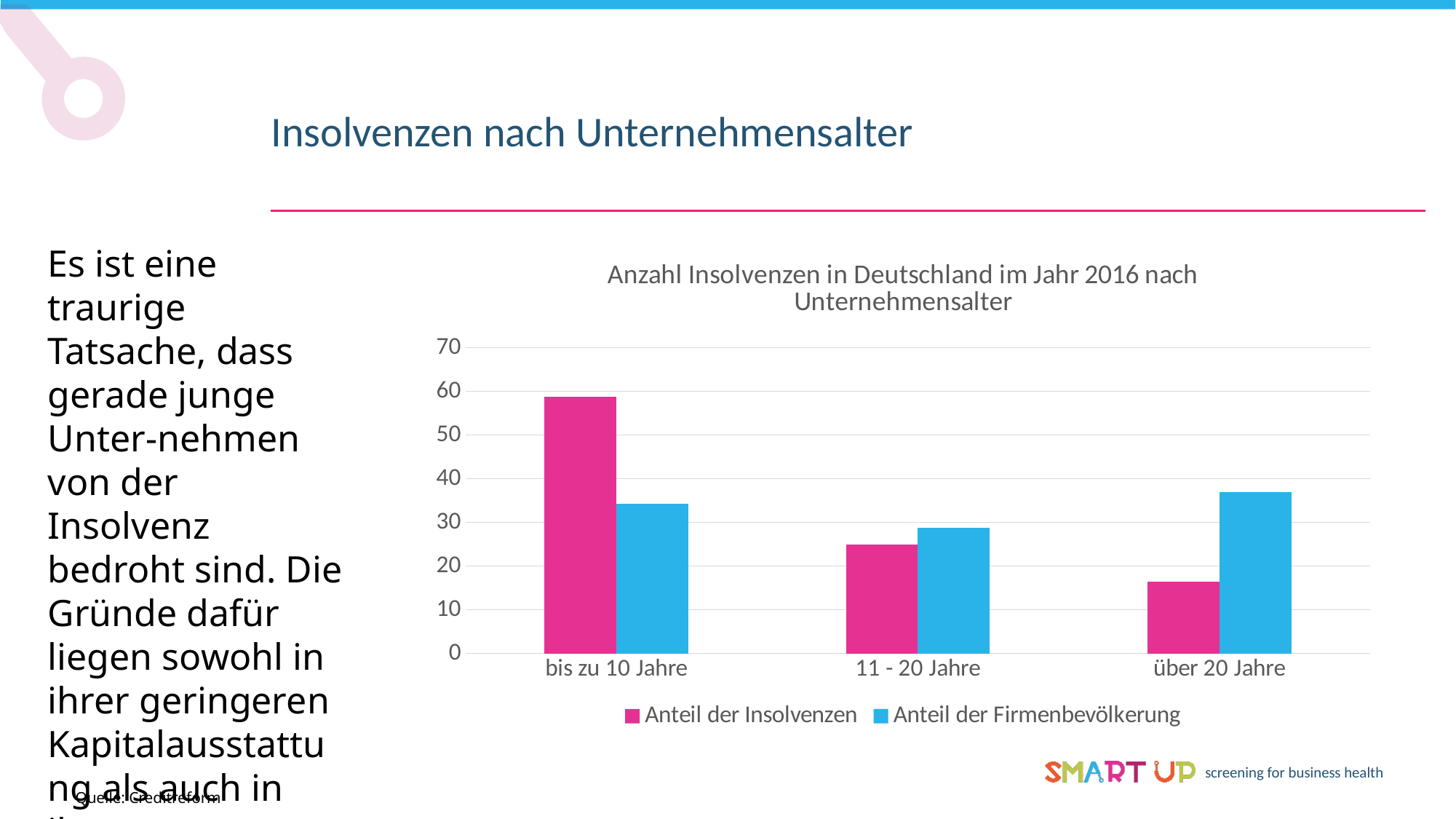
Do the values for Anteil der Insolvenzen rise or fall from bis zu 10 Jahre to über 20 Jahre? fall Is the value for Anteil der Insolvenzen for bis zu 10 Jahre greater or less than 50? greater How many age categories are shown on the x axis? 3 Is the value for Anteil der Insolvenzen for über 20 Jahre greater or less than 20? less Which category has the lowest value for Anteil der Insolvenzen? über 20 Jahre For über 20 Jahre, which is larger: Anteil der Insolvenzen or Anteil der Firmenbevölkerung? Anteil der Firmenbevölkerung Which category has the lowest value for Anteil der Firmenbevölkerung? 11 - 20 Jahre Which category has the highest value for Anteil der Insolvenzen? bis zu 10 Jahre Is the value for Anteil der Firmenbevölkerung for über 20 Jahre greater or less than 30? greater What is the title of the chart? Anzahl Insolvenzen in Deutschland im Jahr 2016 nach Unternehmensalter How many series does the legend list? 2 What kind of chart is shown on the slide? bar chart